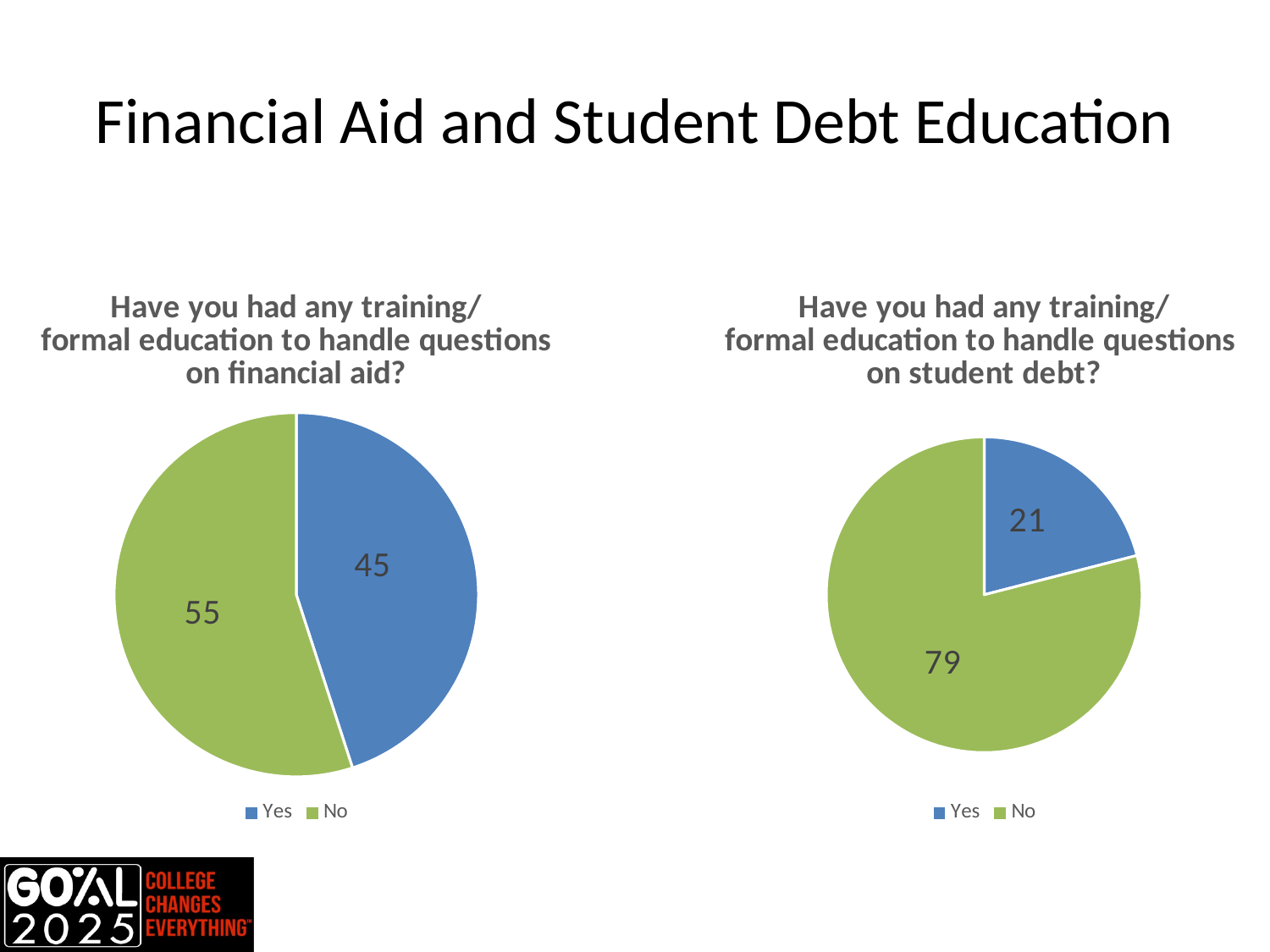
In the right chart (student debt), what is the difference between the No and Yes values? 58 Is the Yes value larger in the left chart (financial aid) or the right chart (student debt)? Left chart (financial aid) In the right chart (student debt), what is the value for Yes? 21 In the left chart (financial aid), what is the value for Yes? 45 In the left chart (financial aid), what is the difference between the No and Yes values? 10 In the left chart (financial aid), what is the value for No? 55 What type of chart is used on this slide? Pie chart How many categories does the legend of the right chart (student debt) list? 2 In the left chart (financial aid), what colour is the No slice? Green In the left chart (financial aid), which category has the smallest slice? Yes In the right chart (student debt), what is the value for No? 79 In the right chart (student debt), which category has the largest slice? No